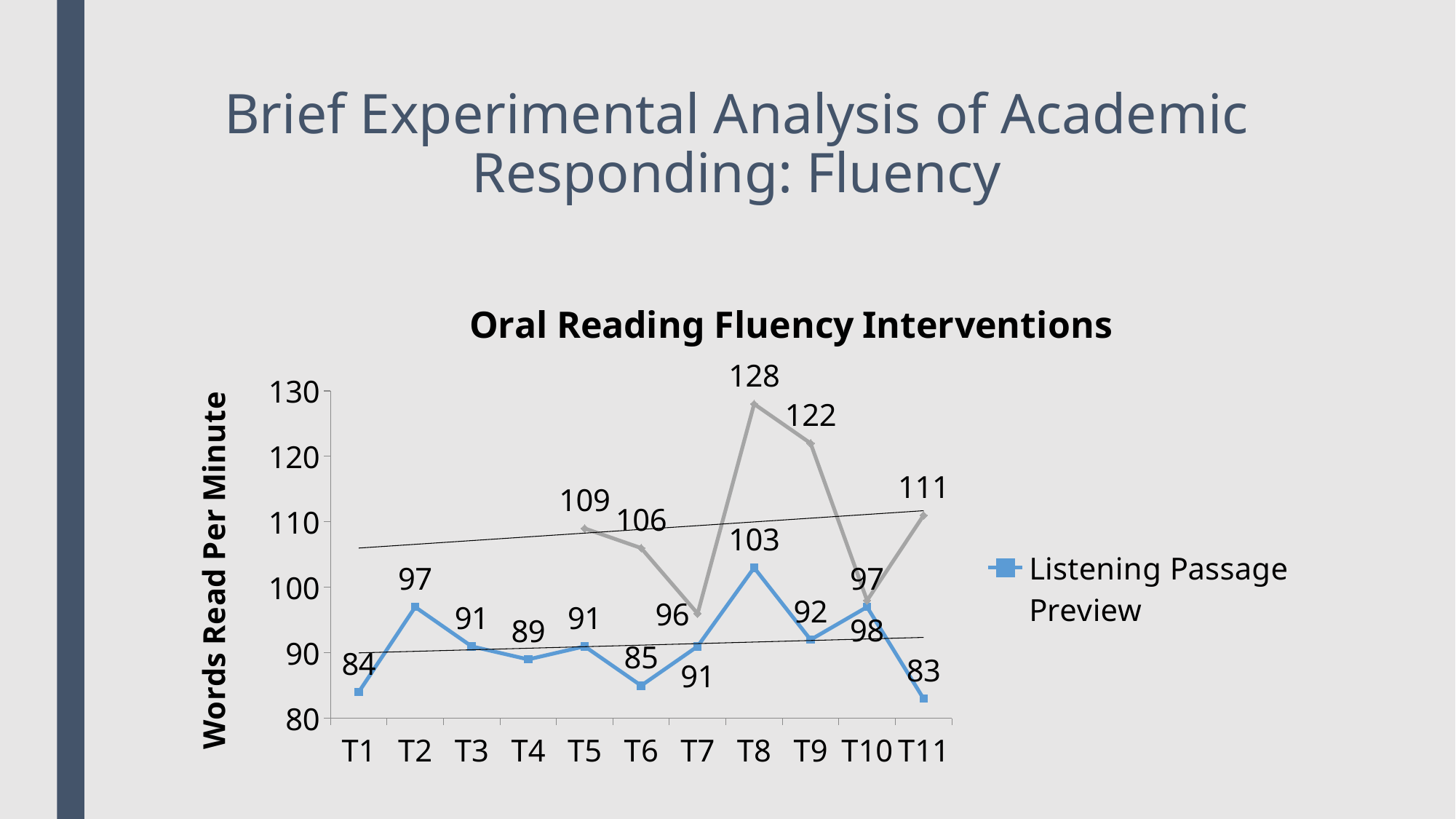
In the Oral Reading Fluency Interventions chart, at which time point is the Listening Passage Preview value lowest? T11 In the Oral Reading Fluency Interventions chart, at which time point is the Listening Passage Preview value highest? T8 In the Oral Reading Fluency Interventions chart, what is the Listening Passage Preview value at T8? 103 In the Oral Reading Fluency Interventions chart, is the Listening Passage Preview value at T8 greater or less than 100? greater In the Oral Reading Fluency Interventions chart, what is the difference between the Listening Passage Preview values at T8 and T1? 19 In the Oral Reading Fluency Interventions chart, what is the Listening Passage Preview value at T1? 84 In the Oral Reading Fluency Interventions chart, which is larger for Listening Passage Preview: the value at T2 or the value at T9? T2 In the Oral Reading Fluency Interventions chart, what is the Listening Passage Preview value at T11? 83 What kind of chart is the Oral Reading Fluency Interventions chart? Line chart How many series does the legend of the Oral Reading Fluency Interventions chart list? 1 What is the y-axis title of the Oral Reading Fluency Interventions chart? Words Read Per Minute How many time points are shown on the x axis of the Oral Reading Fluency Interventions chart? 11